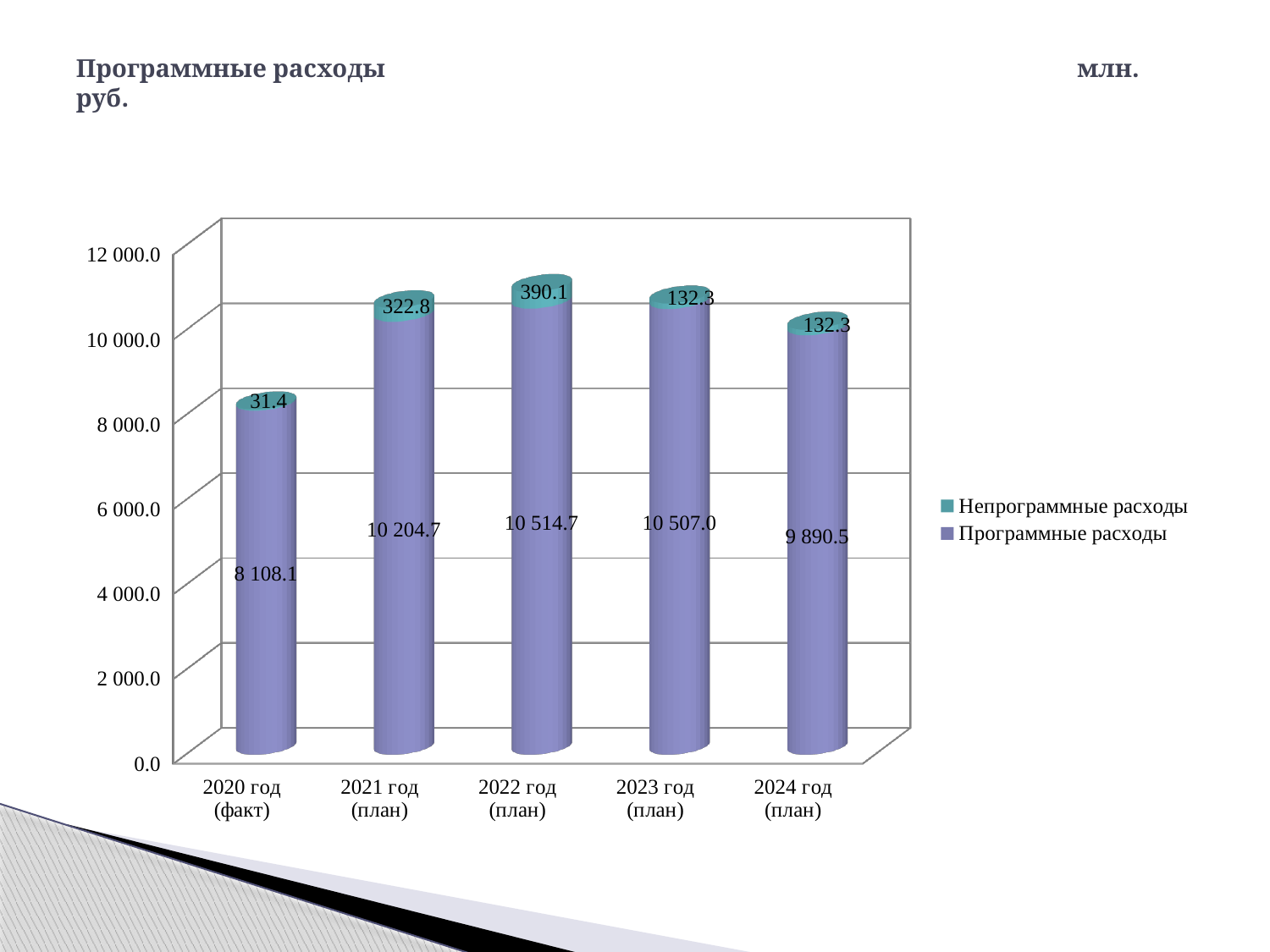
What is the value of Программные расходы for 2020 год (факт)? 8 108.1 What is the total of the stacked bar for 2022 год (план)? 10 904.8 What kind of chart is shown on the slide? Stacked bar chart What is the value of Непрограммные расходы for 2022 год (план)? 390.1 How many year categories are shown on the x axis? 5 What is the difference between Программные расходы in 2022 год (план) and 2021 год (план)? 310.0 What is the value of Программные расходы for 2021 год (план)? 10 204.7 Which is larger: Программные расходы in 2024 год (план) or in 2023 год (план)? 2023 год (план) Which year has the highest value of Программные расходы? 2022 год (план) How many series does the legend list? 2 What is the total of the stacked bar for 2020 год (факт)? 8 139.5 Which year has the lowest value of Непрограммные расходы? 2020 год (факт)